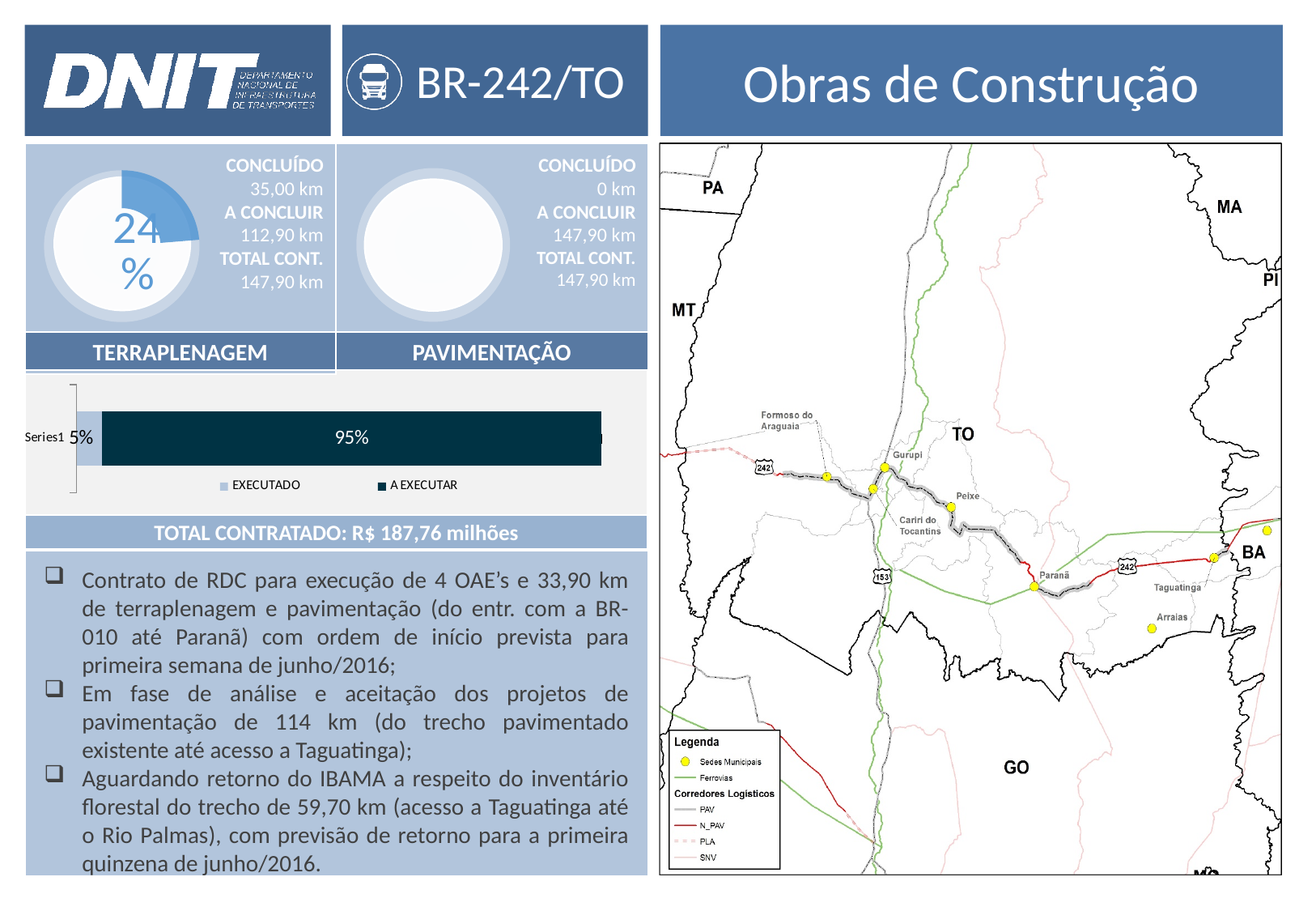
In the stacked bar chart below the donut charts, what is the difference between the A EXECUTAR and EXECUTADO values? 90% What kind of chart is the chart with the EXECUTADO and A EXECUTAR legend? Stacked bar chart Which of the two donut charts shows a larger completed share, TERRAPLENAGEM or PAVIMENTAÇÃO? TERRAPLENAGEM What is the category label on the axis of the stacked bar chart? Series1 In the TERRAPLENAGEM donut chart, what percentage is shown in the centre? 24% How many bars are plotted in the stacked bar chart below the donut charts? 1 How many series does the legend of the stacked bar chart list? 2 In the stacked bar chart below the donut charts, which segment is larger, EXECUTADO or A EXECUTAR? A EXECUTAR In the stacked bar chart below the donut charts, what is the value for EXECUTADO? 5% In the stacked bar chart below the donut charts, what is the total of the Series1 bar? 100% In the stacked bar chart below the donut charts, what is the value for A EXECUTAR? 95% In the stacked bar chart, which legend entry is shown in dark colour? A EXECUTAR